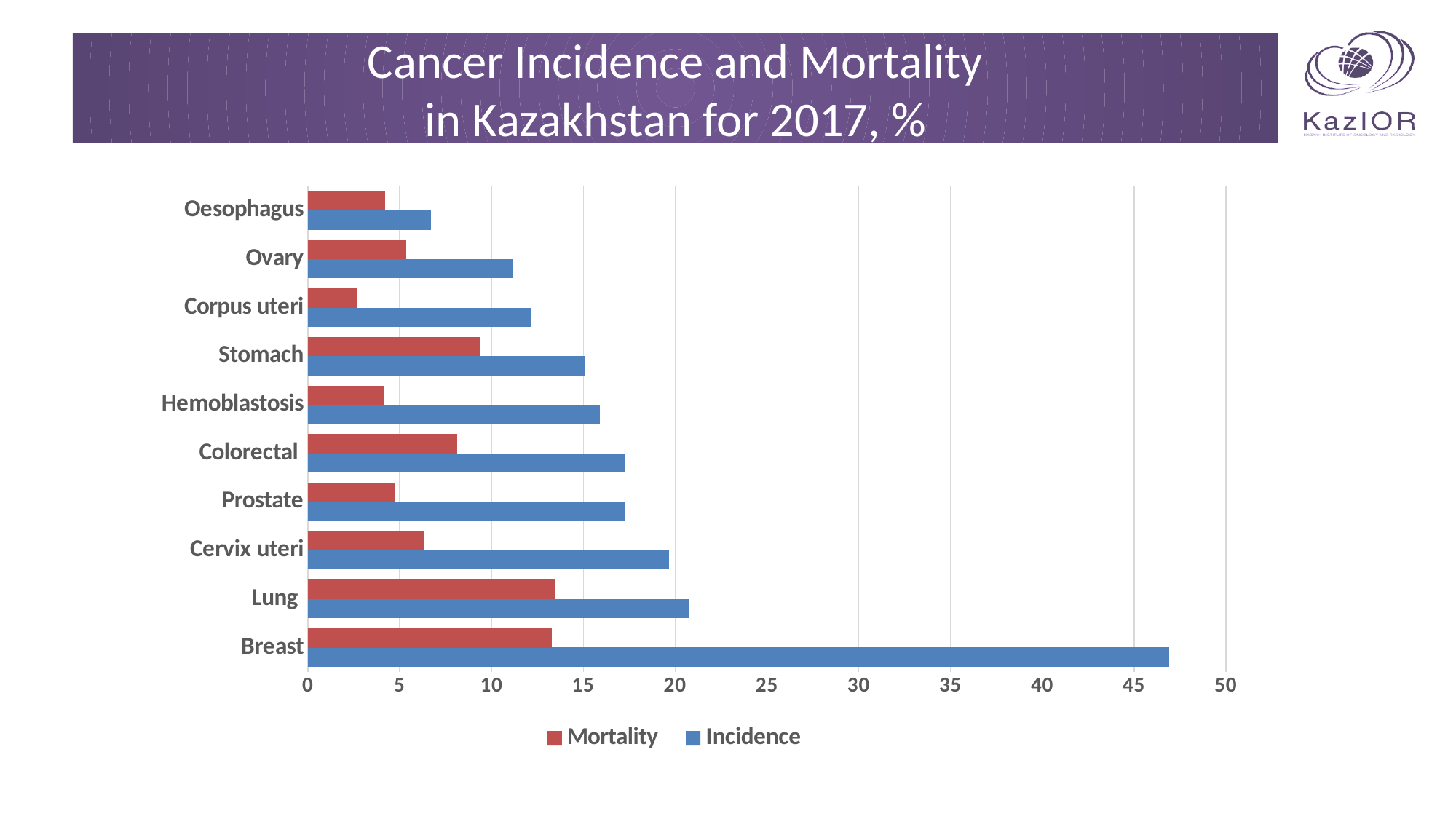
Is the incidence value for Lung greater or less than 20? greater Which cancer type has the lowest mortality? Corpus uteri Is the mortality value for Corpus uteri greater or less than 5? less Is the incidence value for Breast greater or less than 45? greater What type of chart is shown on the slide? Bar chart Which colour represents the Mortality series in the chart? Red Which is larger, the incidence for Cervix uteri or the incidence for Prostate? Cervix uteri How many series does the legend list? 2 Which cancer type has the lowest incidence? Oesophagus How many cancer types are listed on the chart? 10 Which cancer type has the highest incidence? Breast